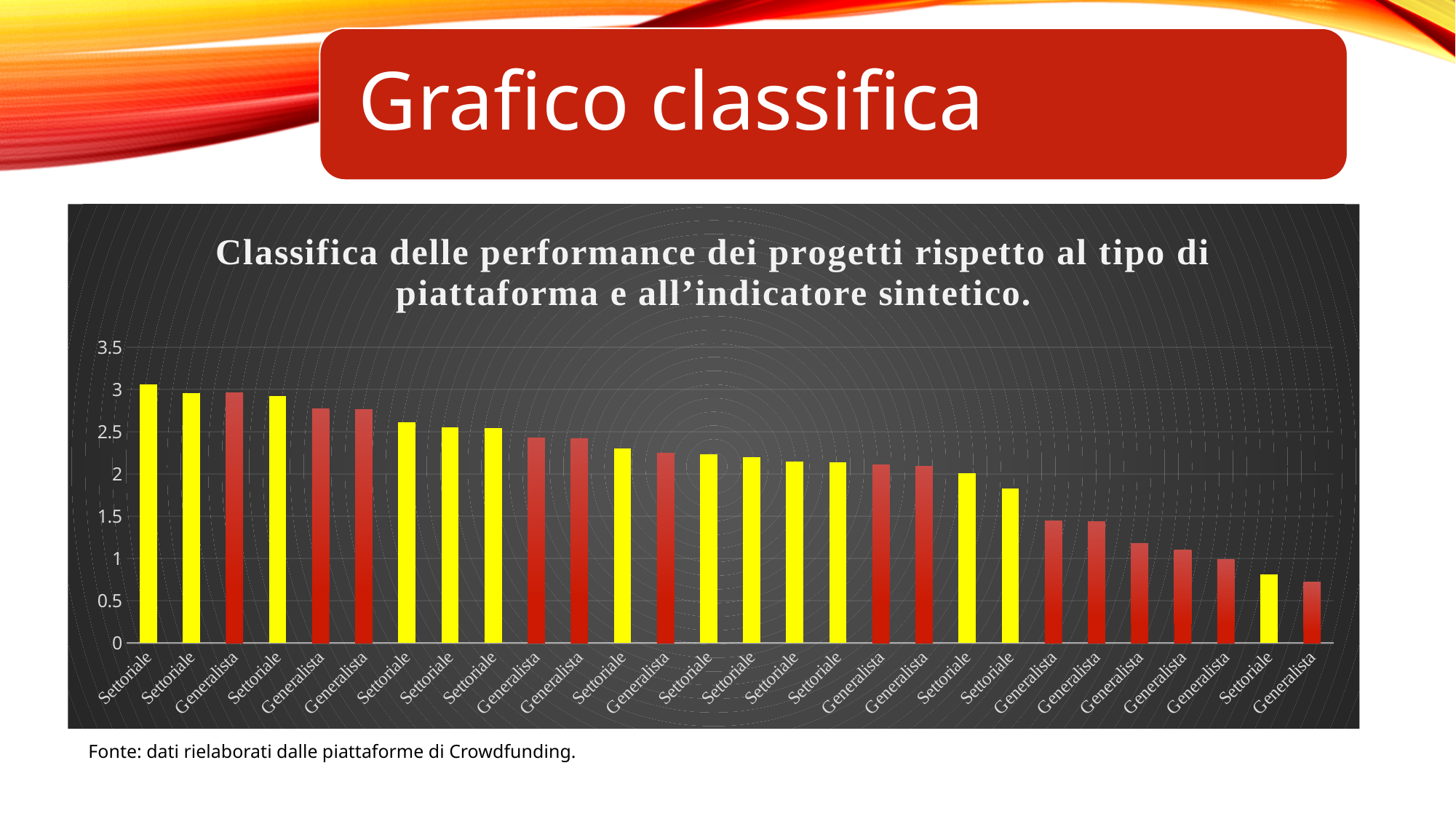
How many bars are labelled "Generalista" in the chart? 14 Is the value of the first bar on the left greater or less than 2.5? greater How many bars are plotted in the chart? 28 Is the value of the first bar on the left larger or smaller than the value of the last bar on the right? larger What is the title of the chart? Classifica delle performance dei progetti rispetto al tipo di piattaforma e all'indicatore sintetico. Do the bar values rise or fall from left to right along the x axis? fall Is the value of the last bar on the right greater or less than 1? less Which label does the tallest bar (the first bar on the left) carry? Settoriale How many bars are labelled "Settoriale" in the chart? 14 What kind of chart is shown on the slide? bar chart Which label does the shortest bar (the last bar on the right) carry? Generalista What colour are the bars labelled "Settoriale"? yellow